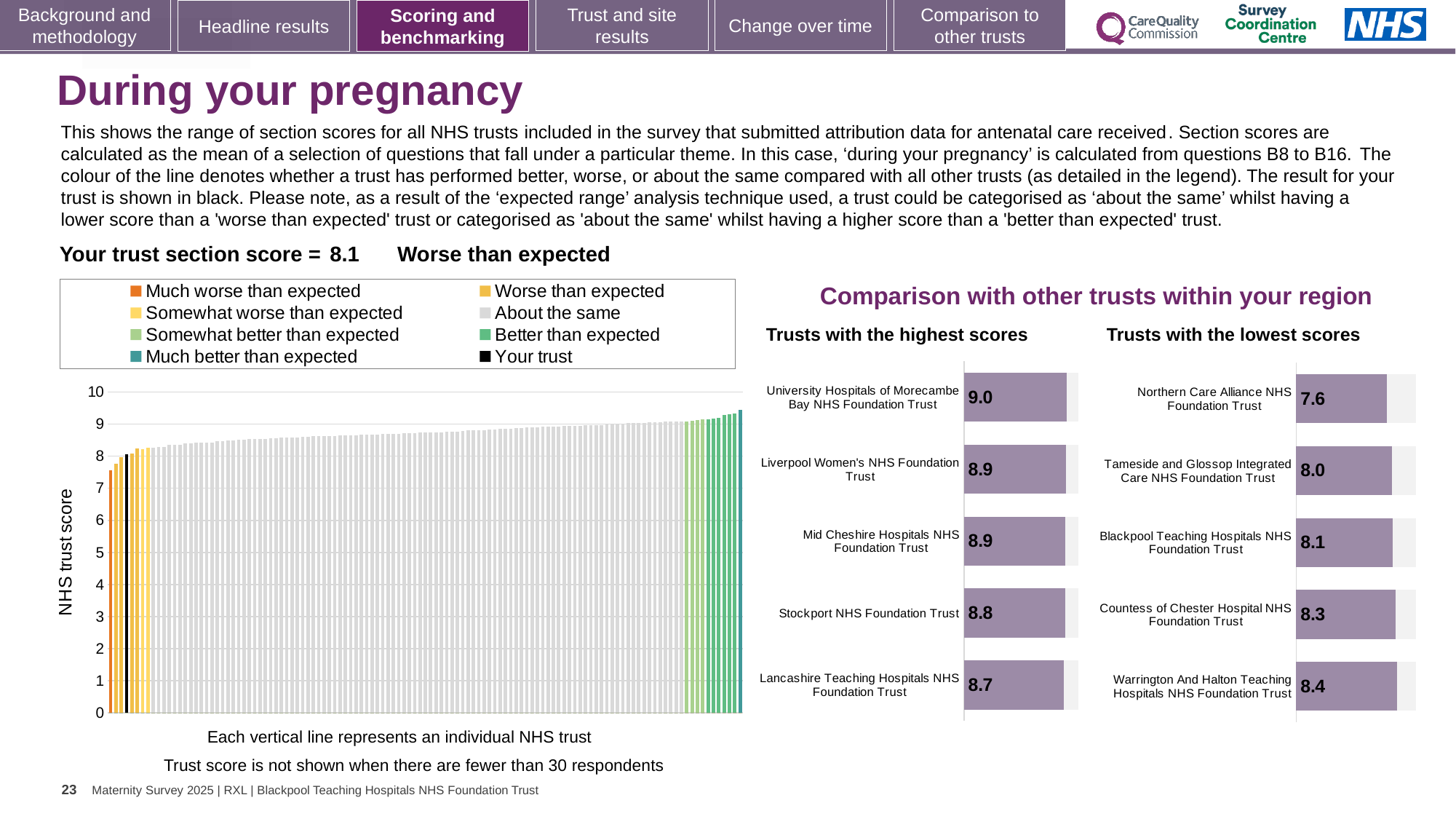
What kind of chart is the large chart on the left with the 'NHS trust score' axis? Bar chart How many entries does the legend above the large chart on the left list? 8 In the large chart on the left with the 'NHS trust score' axis, do the values rise or fall from left to right? Rise In the 'Trusts with the highest scores' chart, what is the difference between the scores of University Hospitals of Morecambe Bay NHS Foundation Trust and Lancashire Teaching Hospitals NHS Foundation Trust? 0.3 In the 'Trusts with the lowest scores' chart, what is the score for Northern Care Alliance NHS Foundation Trust? 7.6 In the 'Trusts with the lowest scores' chart, which trust has the lowest score? Northern Care Alliance NHS Foundation Trust How many trusts are shown in the 'Trusts with the highest scores' chart? 5 In the 'Trusts with the lowest scores' chart, what is the score for Blackpool Teaching Hospitals NHS Foundation Trust? 8.1 In the 'Trusts with the highest scores' chart, what is the score for Stockport NHS Foundation Trust? 8.8 In the 'Trusts with the lowest scores' chart, what is the difference between the scores of Warrington And Halton Teaching Hospitals NHS Foundation Trust and Northern Care Alliance NHS Foundation Trust? 0.8 In the 'Trusts with the lowest scores' chart, which has the higher score: Tameside and Glossop Integrated Care NHS Foundation Trust or Countess of Chester Hospital NHS Foundation Trust? Countess of Chester Hospital NHS Foundation Trust In the 'Trusts with the highest scores' chart, which trust has the highest score? University Hospitals of Morecambe Bay NHS Foundation Trust